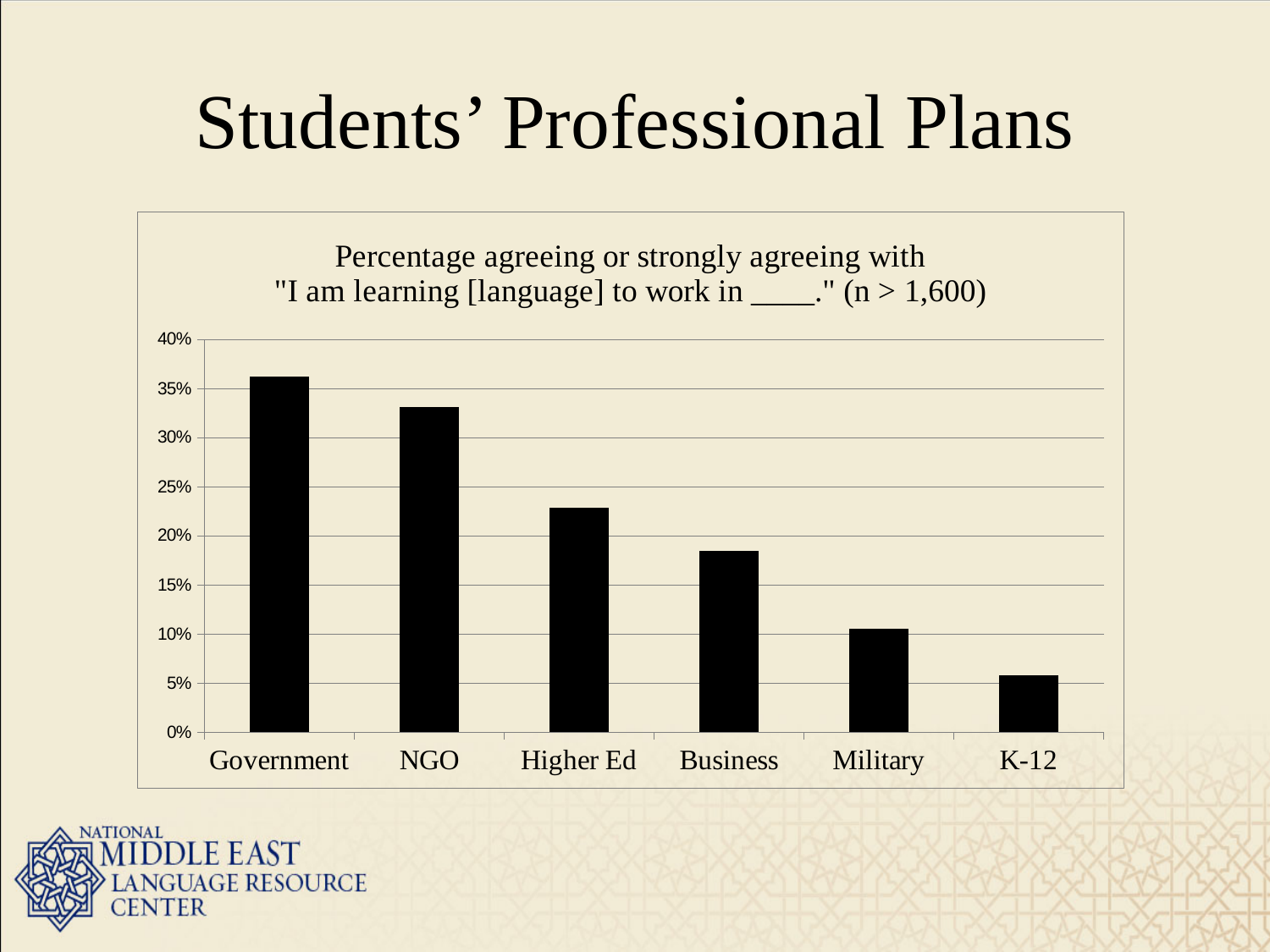
Is the value for Government greater or less than 35%? greater Do the values rise or fall moving from left to right along the x axis? fall What sample size is stated in the chart title? n > 1,600 Which category has the lowest value in the chart? K-12 Is the value for Higher Ed greater or less than 25%? less Is the value for Business greater or less than 20%? less How many categories are shown on the x axis of the chart? 6 Which category has the highest value in the chart? Government Which has a larger value, Higher Ed or Business? Higher Ed What kind of chart is shown on the slide? bar chart